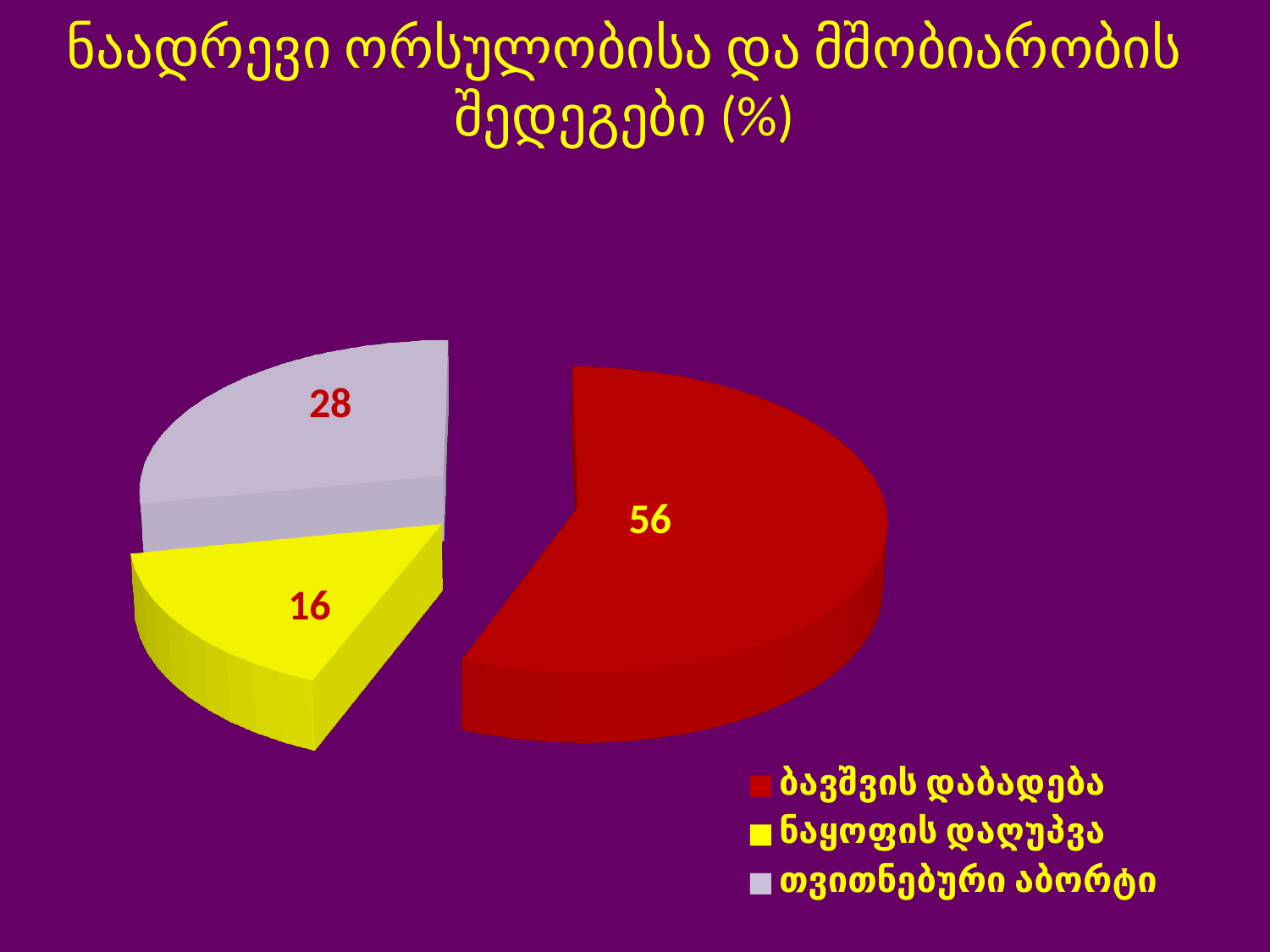
What colour is the slice for ნაყოფის დაღუპვა? yellow What type of chart is shown on the slide? pie chart What value is shown for ნაყოფის დაღუპვა? 16 How many slices does the pie chart have? 3 Which category has the smallest slice of the pie? ნაყოფის დაღუპვა What value is shown for თვითნებური აბორტი? 28 Which category has the largest slice of the pie? ბავშვის დაბადება What is the title of the chart on the slide? ნაადრევი ორსულობისა და მშობიარობის შედეგები (%) What value is shown for ბავშვის დაბადება? 56 Which is larger, the value for თვითნებური აბორტი or the value for ნაყოფის დაღუპვა? თვითნებური აბორტი What is the difference between the values for თვითნებური აბორტი and ნაყოფის დაღუპვა? 12 What is the difference between the values for ბავშვის დაბადება and თვითნებური აბორტი? 28